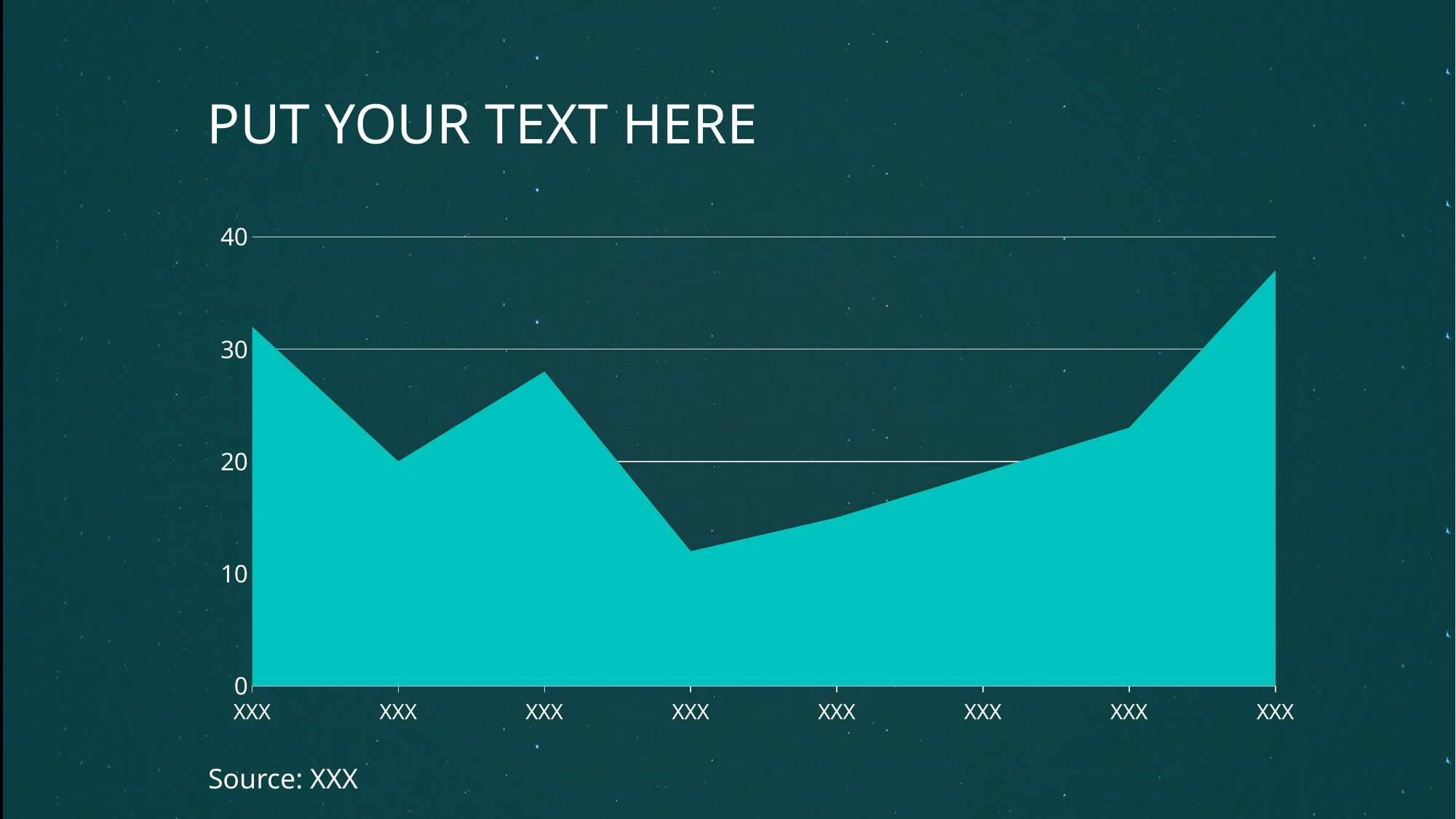
Is the value of the fourth point greater or less than 10? greater Do the values rise or fall from the fourth point to the last point? Rise What is the title of the slide above the chart? PUT YOUR TEXT HERE Which of the two is larger, the value of the second point or the value of the third point? The third point Is the value of the last point greater or less than 40? less Is the value of the seventh point greater or less than 20? greater What kind of chart is shown on the slide? Area chart Which point has the highest value, the first or the last? The last What is the highest value shown on the y axis? 40 How many data points are plotted along the x axis? 8